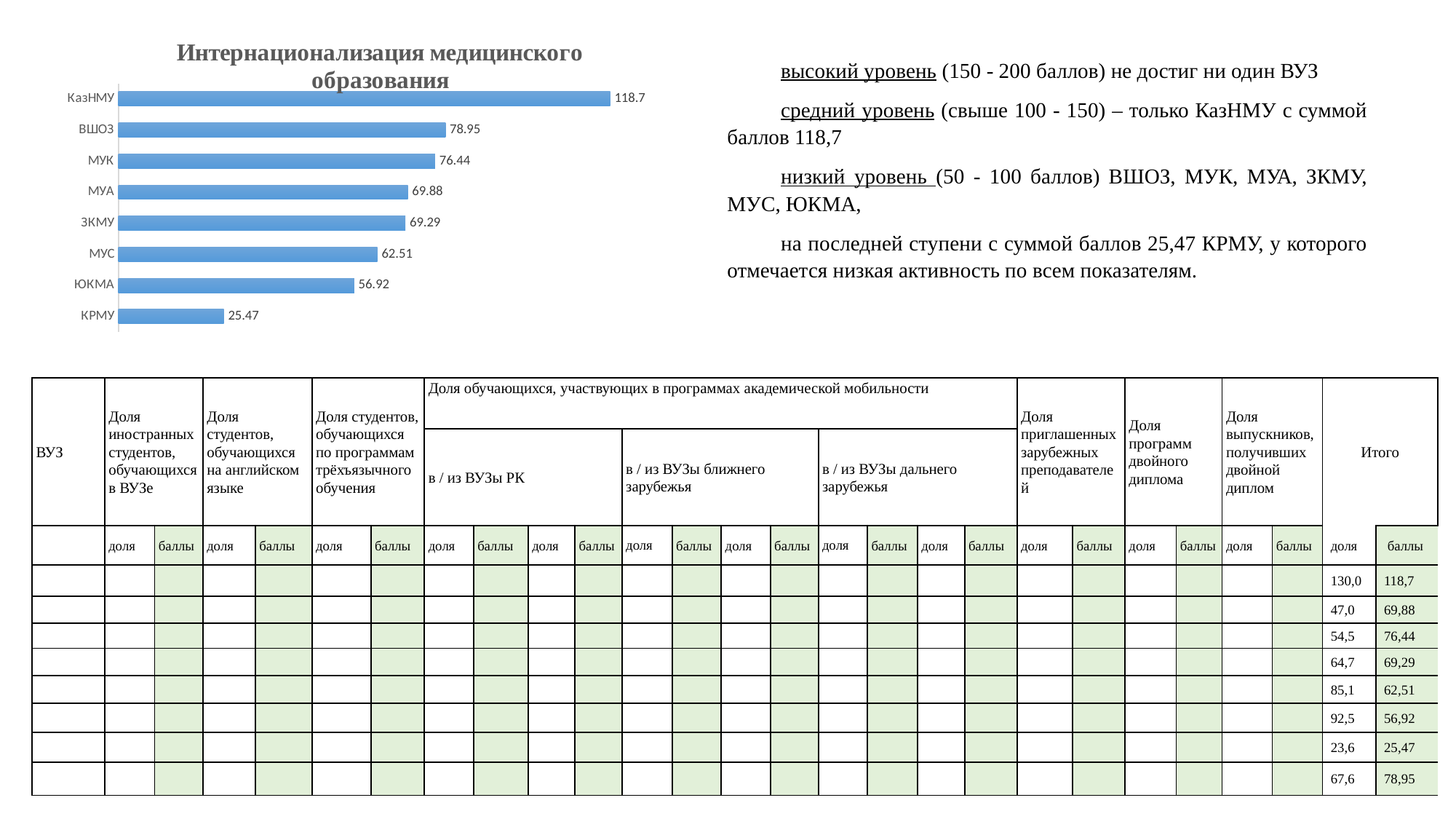
Which category has the lowest value in the chart? КРМУ How many categories are shown in the chart? 8 Which is larger, the value for МУА or the value for МУС? МУА What is the value for ЗКМУ in the chart? 69.29 Which category has the highest value in the chart? КазНМУ What is the difference between the values for ЮКМА and КРМУ? 31.45 What kind of chart is shown on the slide? Bar chart What is the title of the chart? Интернационализация медицинского образования What is the value for КазНМУ in the chart? 118.7 What is the value for МУК in the chart? 76.44 What is the value for ЮКМА in the chart? 56.92 What is the difference between the values for КазНМУ and ВШОЗ? 39.75